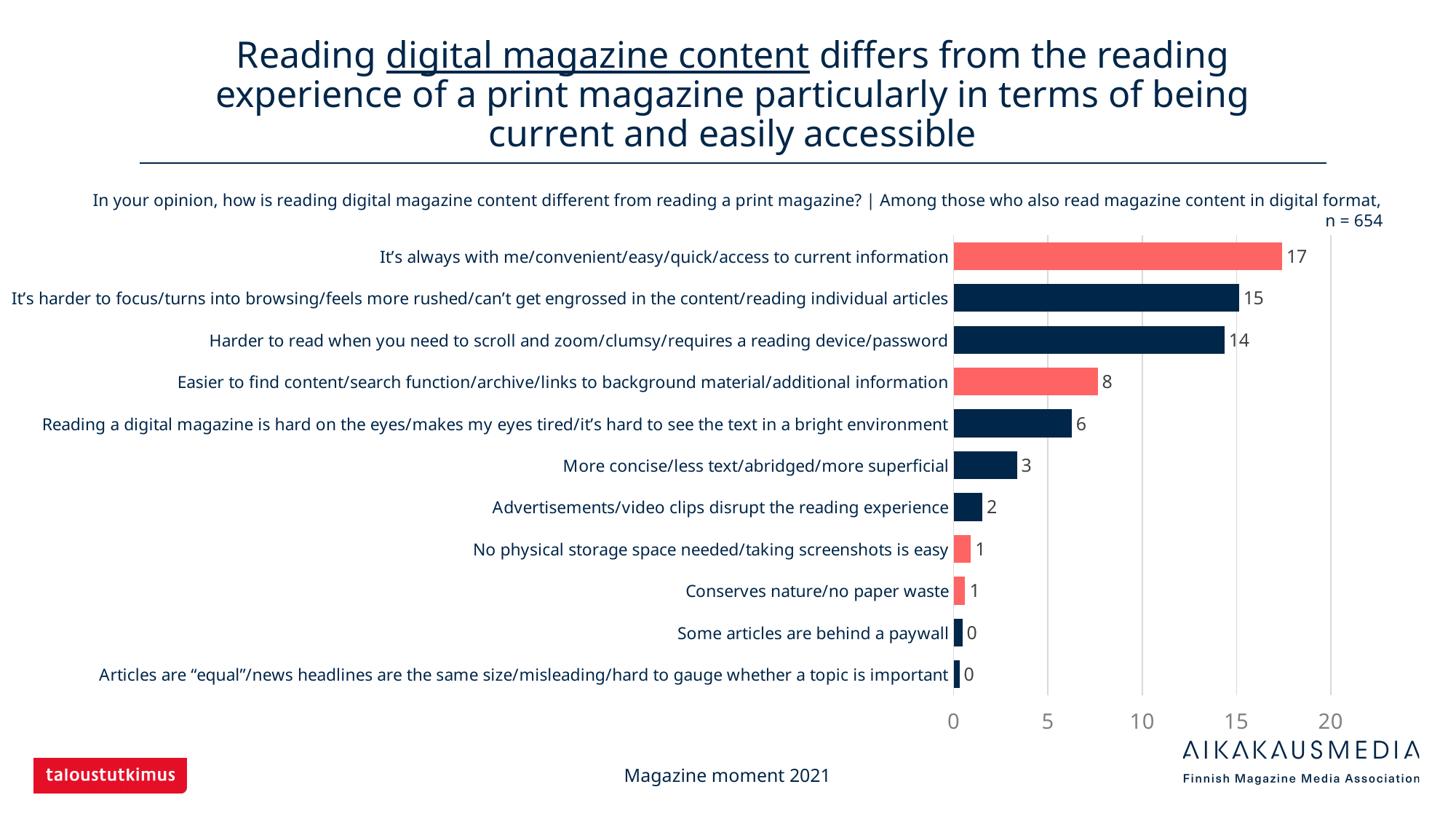
What is the value for "It's always with me/convenient/easy/quick/access to current information"? 17 What is the sample size (n) stated on the slide? n = 654 Which category has the highest value? It's always with me/convenient/easy/quick/access to current information What is the value for "Some articles are behind a paywall"? 0 What is the difference between the values for "It's harder to focus/turns into browsing/feels more rushed/can't get engrossed in the content/reading individual articles" and "Harder to read when you need to scroll and zoom/clumsy/requires a reading device/password"? 1 What is the value for "Advertisements/video clips disrupt the reading experience"? 2 Is the value for "Harder to read when you need to scroll and zoom/clumsy/requires a reading device/password" greater or less than 10? greater How many categories are shown in the chart? 11 Which is larger: the value for "Reading a digital magazine is hard on the eyes/makes my eyes tired/it's hard to see the text in a bright environment" or the value for "More concise/less text/abridged/more superficial"? Reading a digital magazine is hard on the eyes/makes my eyes tired/it's hard to see the text in a bright environment What is the value for "Easier to find content/search function/archive/links to background material/additional information"? 8 What is the difference between the values for "It's always with me/convenient/easy/quick/access to current information" and "Easier to find content/search function/archive/links to background material/additional information"? 9 What kind of chart is shown on the slide? bar chart